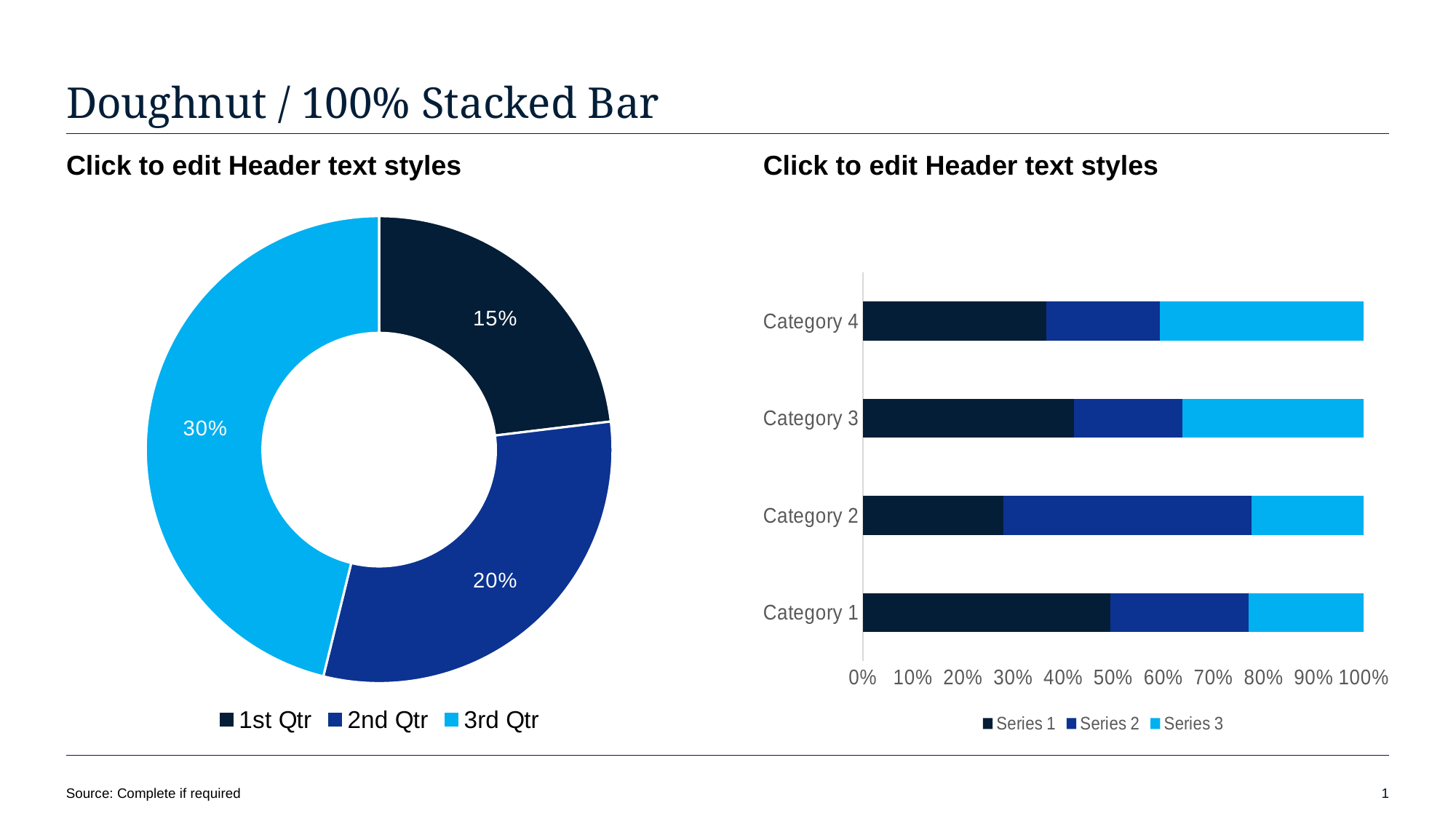
In the doughnut chart on the left, which quarter has the largest slice? 3rd Qtr What kind of chart is shown on the right side of the slide? Stacked bar chart What kind of chart is shown on the left side of the slide? Doughnut chart In the doughnut chart on the left, what is the difference between the 3rd Qtr and 2nd Qtr values? 10% In the stacked bar chart on the right, is the Series 1 segment larger for Category 1 or Category 2? Category 1 How many series does the legend of the stacked bar chart on the right list? 3 In the stacked bar chart on the right, is the Series 1 segment for Category 1 greater or less than 40%? greater In the doughnut chart on the left, what is the value shown for 1st Qtr? 15% How many entries does the legend of the left doughnut chart list? 3 In the doughnut chart on the left, which quarter has the smallest slice? 1st Qtr In the doughnut chart on the left, what is the value shown for 3rd Qtr? 30% How many categories are shown in the stacked bar chart on the right? 4